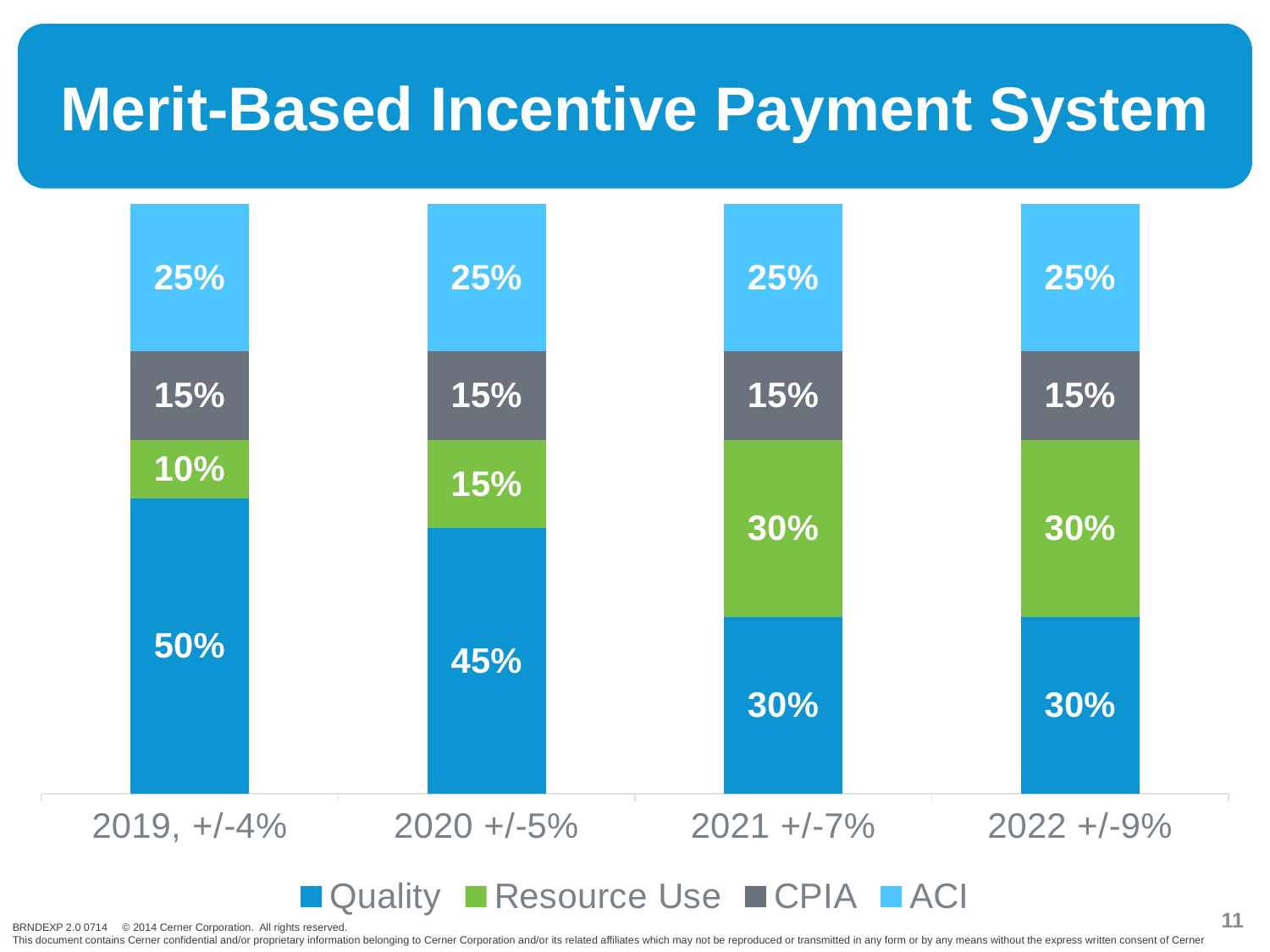
What is the Resource Use value for 2020 +/-5%? 15% How many categories are shown on the x axis? 4 Which is larger: the Resource Use value for 2021 +/-7% or the Resource Use value for 2020 +/-5%? 2021 +/-7% Does the Quality value rise or fall from 2019, +/-4% to 2022 +/-9%? Fall What is the CPIA value for 2021 +/-7%? 15% What kind of chart is shown on the slide? Stacked bar chart What is the difference between the Quality value for 2019, +/-4% and the Quality value for 2020 +/-5%? 5% What is the Quality value for 2019, +/-4%? 50% Which category has the lowest Resource Use value? 2019, +/-4% How many series does the legend list? 4 Which category has the highest Quality value? 2019, +/-4% What is the ACI value for 2022 +/-9%? 25%